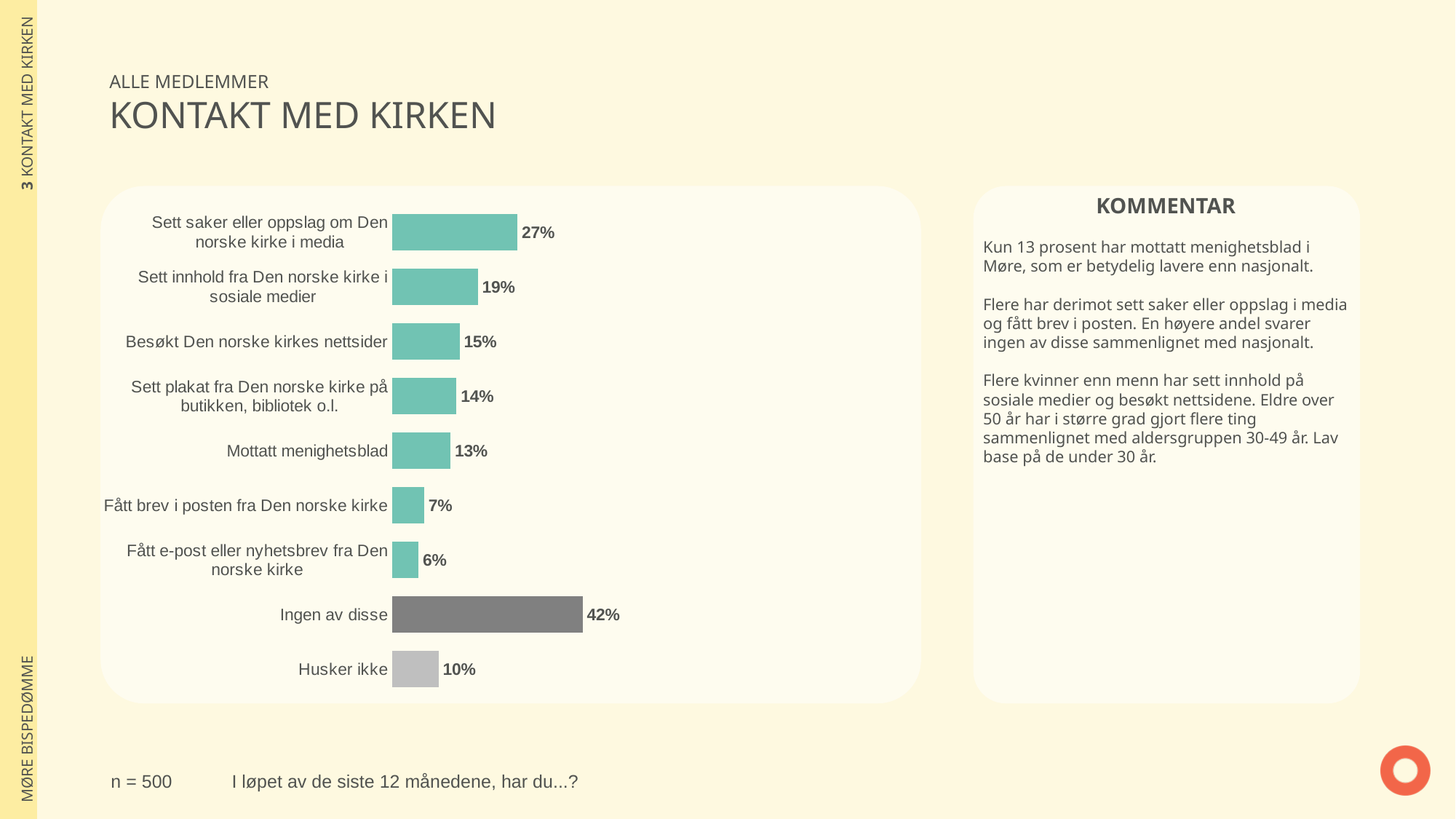
What is the value for "Mottatt menighetsblad"? 13% What type of chart is shown on the slide? Bar chart What is the difference between "Sett innhold fra Den norske kirke i sosiale medier" and "Besøkt Den norske kirkes nettsider"? 4 percentage points What is the value for "Fått e-post eller nyhetsbrev fra Den norske kirke"? 6% Which category has the lowest value in the chart? Fått e-post eller nyhetsbrev fra Den norske kirke Which category has the highest value in the chart? Ingen av disse What is the sample size (n) stated on the slide? n = 500 What percentage of respondents have seen cases or coverage about Den norske kirke in media ("Sett saker eller oppslag om Den norske kirke i media")? 27% What is the difference between "Ingen av disse" and "Sett saker eller oppslag om Den norske kirke i media"? 15 percentage points Which is larger: "Fått brev i posten fra Den norske kirke" or "Husker ikke"? Husker ikke Which bar in the chart is coloured dark grey? Ingen av disse How many categories are shown in the chart? 9